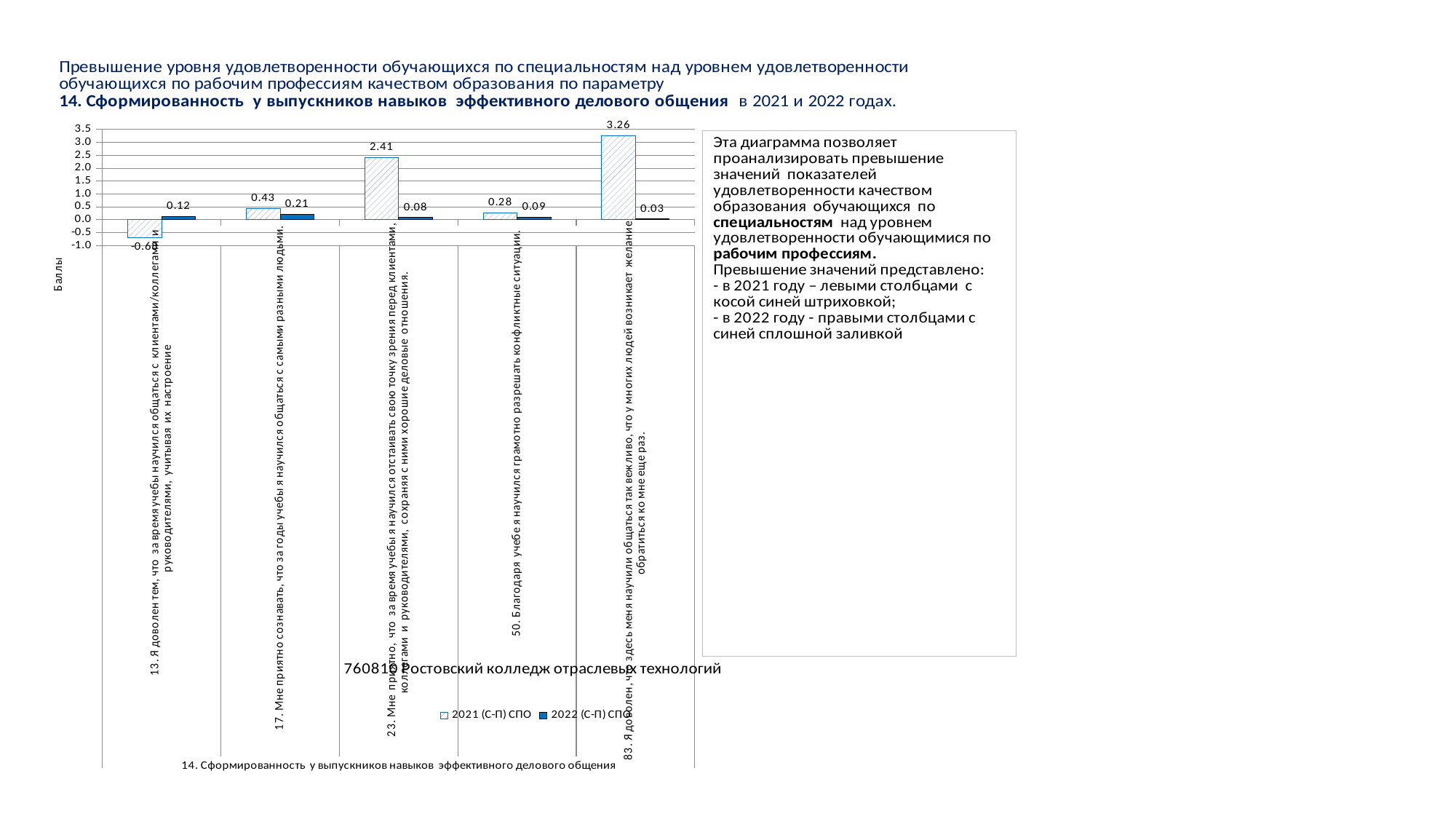
What is the 2022 (С-П) СПО value for category 13 ("Я доволен тем, что за время учебы научился общаться с клиентами/коллегами...")? 0.12 What is the difference between the 2021 and 2022 values for category 23? 2.33 What kind of chart is shown on the slide? bar chart Is the 2021 (С-П) СПО value for category 83 greater or less than 3.0? greater What is the 2021 (С-П) СПО value for category 83 ("Я доволен, что здесь меня научили общаться так вежливо...")? 3.26 Which category has the highest 2021 (С-П) СПО value? 83 What is the 2022 (С-П) СПО value for category 17 ("Мне приятно сознавать, что за годы учебы я научился общаться с самыми разными людьми")? 0.21 How many categories (questions) are shown on the x axis of the chart? 5 Which category has the lowest 2022 (С-П) СПО value? 83 How many series does the chart legend list? 2 Which category has the larger 2021 (С-П) СПО value: 17 or 50? 17 What is the 2021 (С-П) СПО value for category 23 ("Мне приятно, что за время учебы я научился отстаивать свою точку зрения...")? 2.41